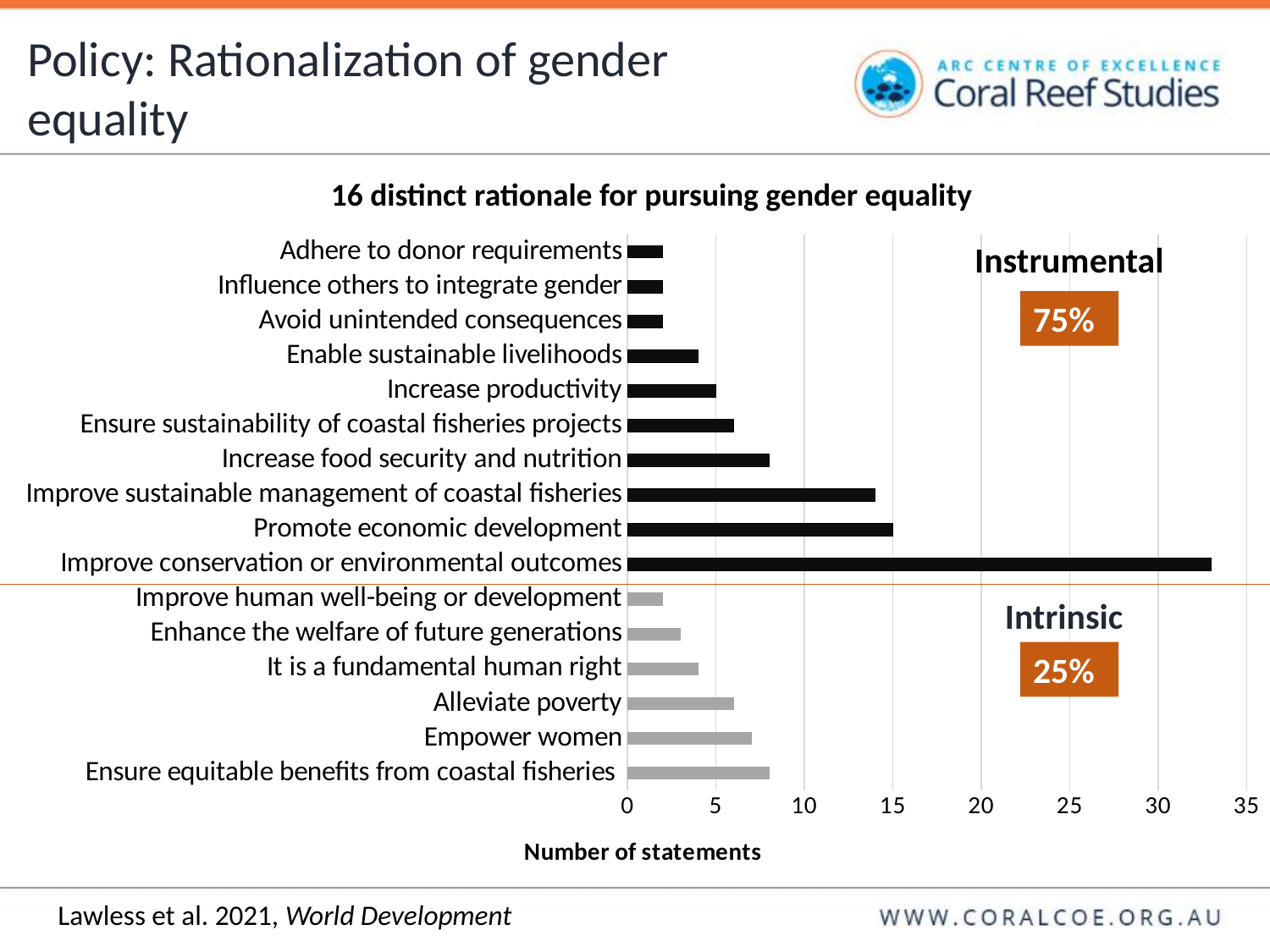
Is the value for Improve conservation or environmental outcomes greater or less than 30? greater How many rationale categories are plotted in the chart? 16 Is the value for Ensure equitable benefits from coastal fisheries greater or less than 5? greater Which rationale has the highest number of statements? Improve conservation or environmental outcomes Is the value for Improve sustainable management of coastal fisheries greater or less than 10? greater Which has more statements: Promote economic development or Increase food security and nutrition? Promote economic development Which has more statements: Empower women or Improve human well-being or development? Empower women What kind of chart is shown on the slide? bar chart What percentage is shown for the Instrumental group of rationales? 75% What is the title of the x axis? Number of statements